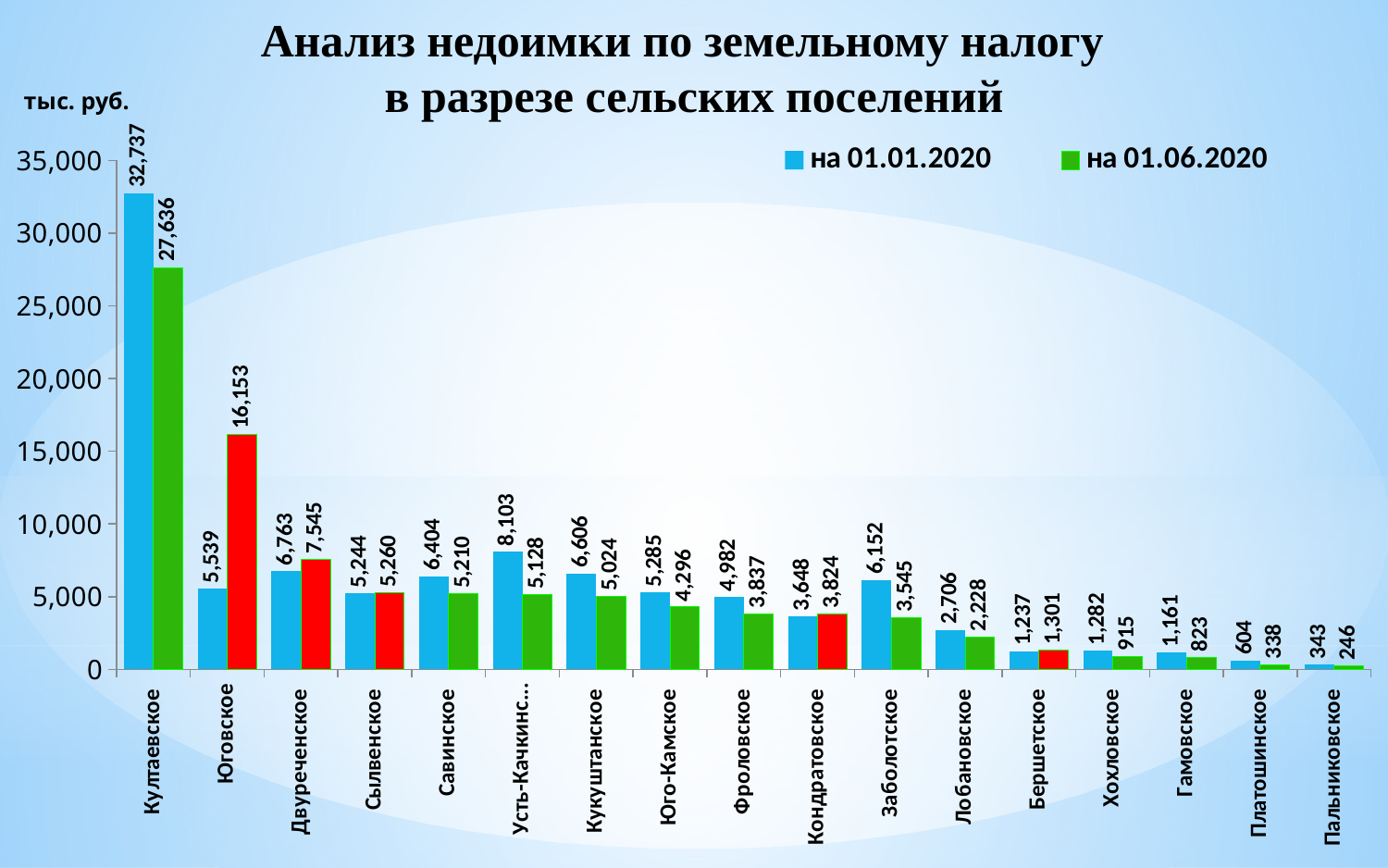
By how much did the value for Юговское increase from 01.01.2020 to 01.06.2020? 10,614 How many series does the legend list? 2 How many settlements are shown on the x axis? 17 For Юговское, which is larger: the value on 01.01.2020 or on 01.06.2020? на 01.06.2020 Which settlement has the highest value in the series 'на 01.01.2020'? Култаевское By how much did the value for Култаевское decrease from 01.01.2020 to 01.06.2020? 5,101 What kind of chart is shown on the slide? Bar chart What unit is indicated for the values on the chart? тыс. руб. What is the value for Култаевское in the series 'на 01.01.2020'? 32,737 What is the value for Юговское in the series 'на 01.06.2020'? 16,153 What is the value for Заболотское in the series 'на 01.01.2020'? 6,152 Which settlement has the lowest value in the series 'на 01.06.2020'? Пальниковское